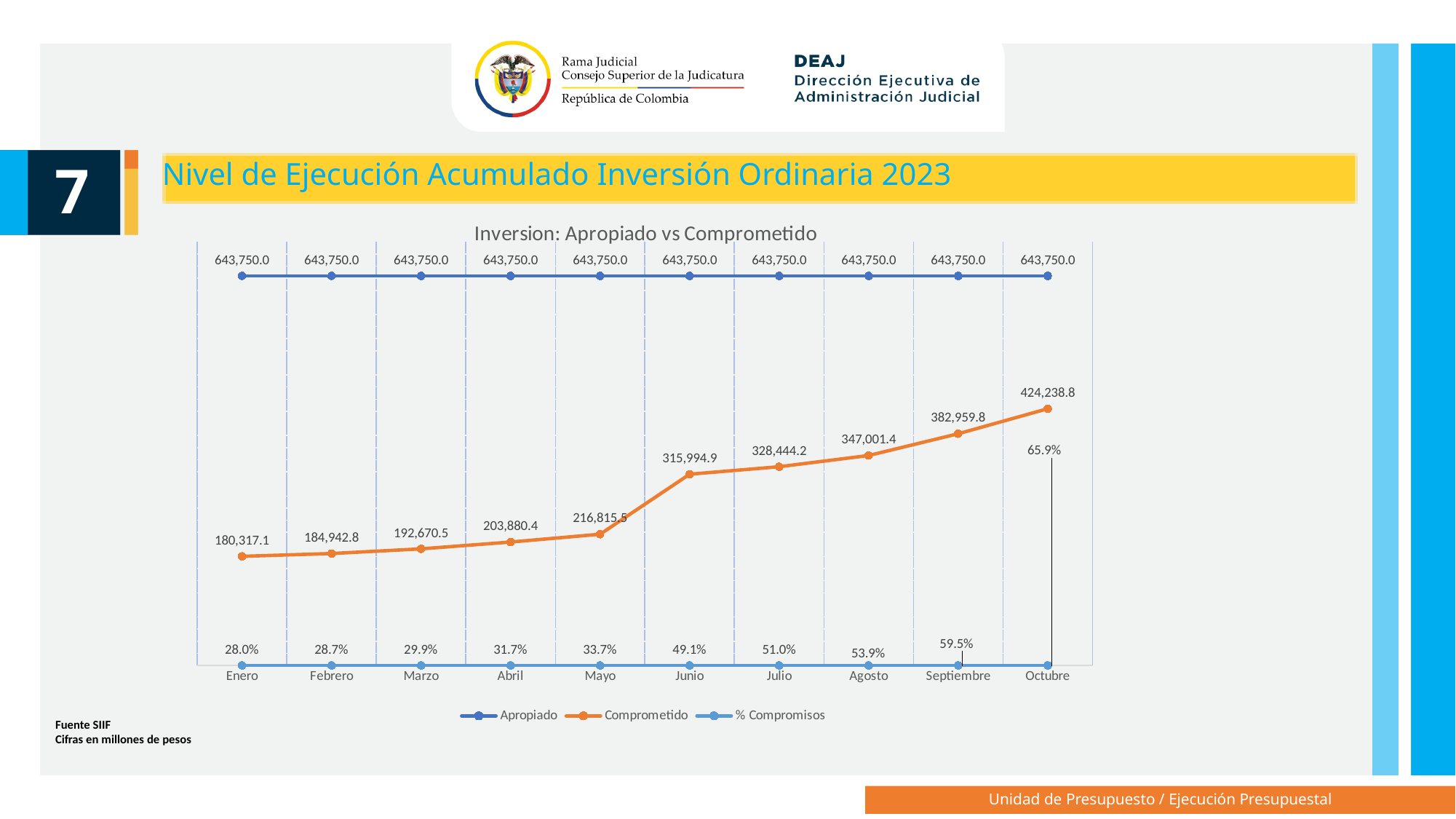
In which month is the Comprometido value highest? Octubre Does the Comprometido series rise or fall from Enero to Octubre? Rise How many months are shown on the x axis? 10 What is the difference between the Apropiado and Comprometido values for Octubre? 219,511.2 How many series does the legend list? 3 In which month is the % Compromisos value lowest? Enero What kind of chart is shown? Line chart Which is larger, the Comprometido value for Mayo or for Junio? Junio What is the Comprometido value for Enero? 180,317.1 What is the % Compromisos value for Octubre? 65.9% What is the Apropiado value for Marzo? 643,750.0 What is the Comprometido value for Junio? 315,994.9